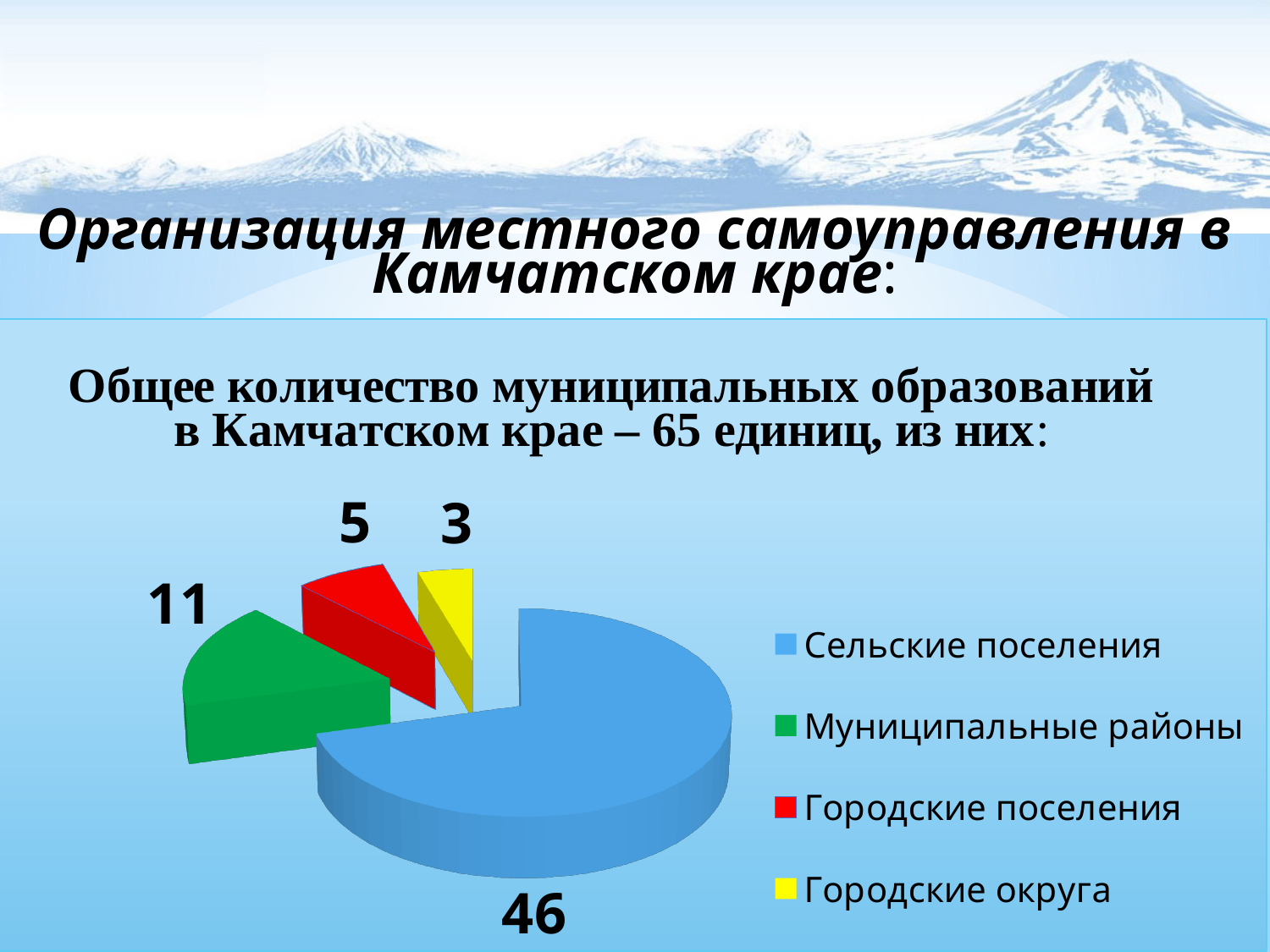
What kind of chart is shown on the slide? pie chart Which is larger: the value for Городские поселения or the value for Городские округа? Городские поселения What is the value for Муниципальные районы in the pie chart? 11 What colour is the slice for Муниципальные районы in the pie chart? green What is the value for Городские поселения in the pie chart? 5 What is the value for Городские округа in the pie chart? 3 Which category has the largest slice in the pie chart? Сельские поселения What is the value for Сельские поселения in the pie chart? 46 How many entries does the legend of the pie chart list? 4 What is the difference between the values for Сельские поселения and Муниципальные районы? 35 Which category has the smallest slice in the pie chart? Городские округа How many slices does the pie chart have? 4